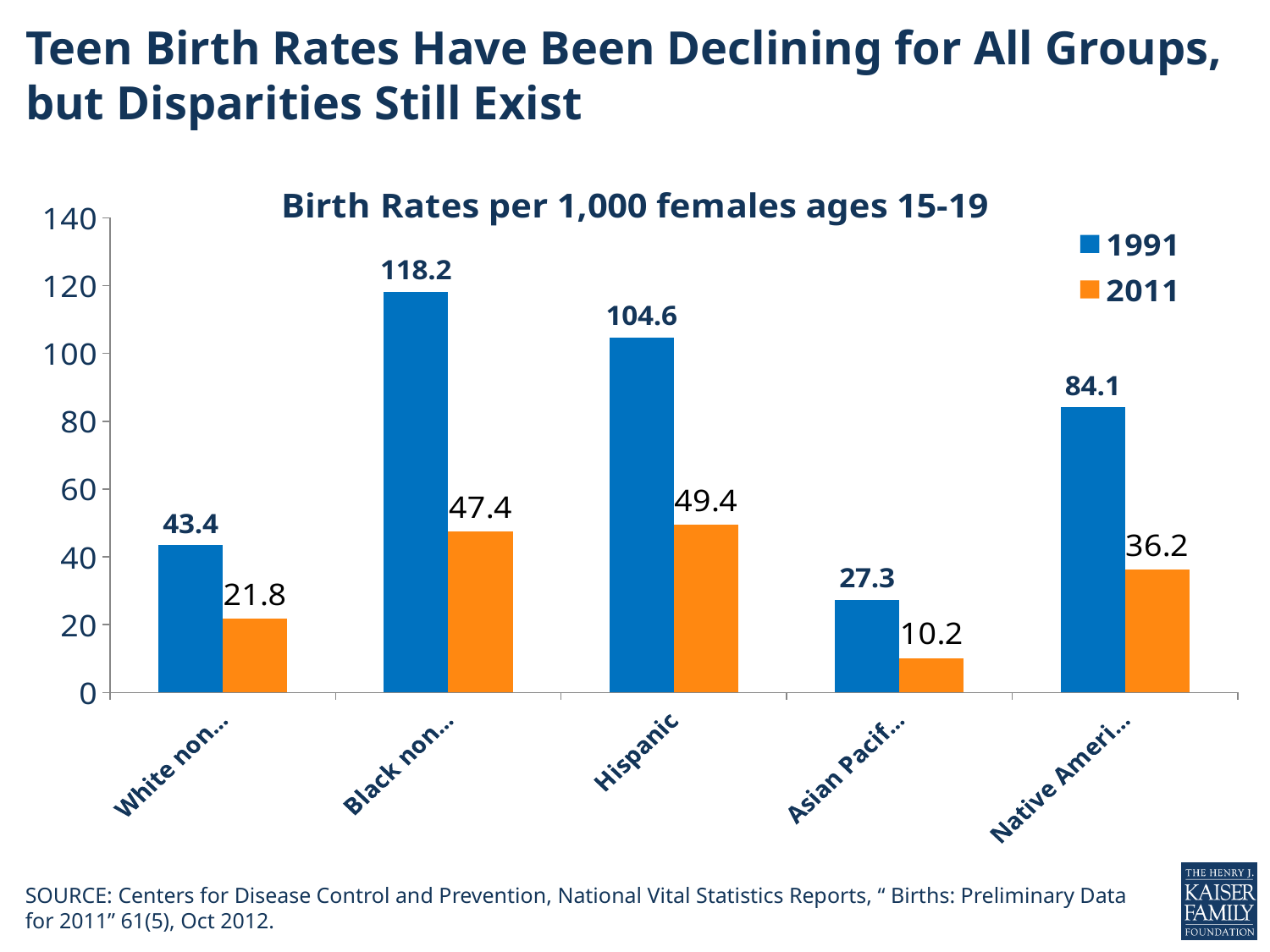
Which category has the lowest 2011 value? Asian Pacif... What is the title of the chart? Birth Rates per 1,000 females ages 15-19 What is the difference between the 1991 and 2011 values for Hispanic? 55.2 What is the difference between the 1991 and 2011 values for the category labeled "Black non..."? 70.8 How many categories are shown on the x axis? 5 What is the 1991 value for the category labeled "White non..."? 43.4 What is the 2011 value for the category labeled "Asian Pacif..."? 10.2 How many series does the legend list? 2 What kind of chart is shown on the slide? Bar chart Which category has the highest 1991 value? Black non... Which is larger in 2011: the value for Hispanic or the value for "Black non..."? Hispanic What is the 1991 value for Hispanic? 104.6